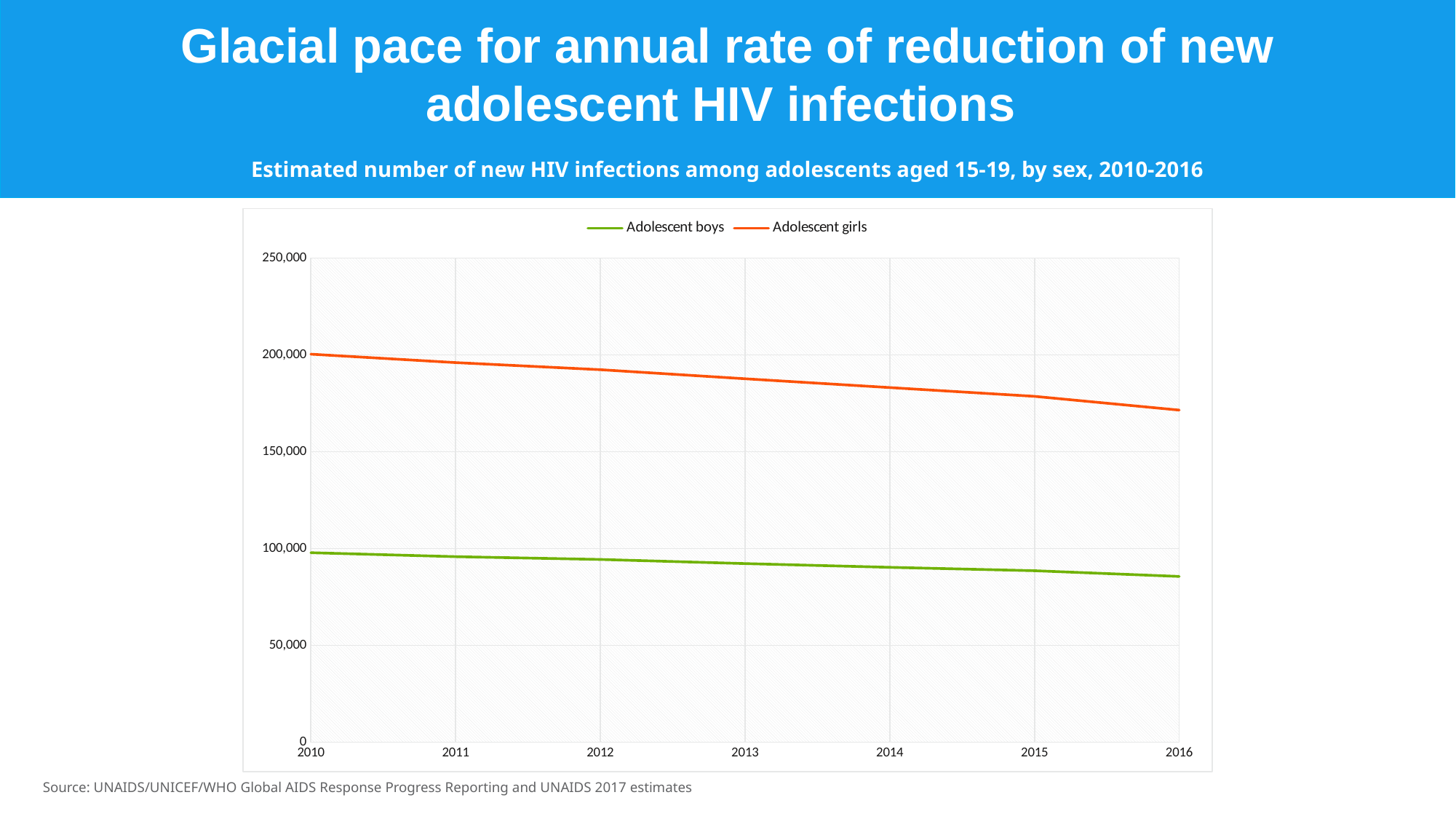
Which series has the higher value in 2016, Adolescent boys or Adolescent girls? Adolescent girls Is the value for Adolescent boys in 2016 greater or less than 50,000? greater Is the value for Adolescent girls in 2016 greater or less than 150,000? greater How many years are plotted along the x axis? 7 Is the value for Adolescent boys in 2010 greater or less than 100,000? less What kind of chart is shown on the slide? Line chart Which colour is used for the Adolescent boys line? Green Do the values for Adolescent boys rise or fall from 2010 to 2016? Fall How many series does the legend list? 2 What is the subtitle describing the chart's data? Estimated number of new HIV infections among adolescents aged 15-19, by sex, 2010-2016 Do the values for Adolescent girls rise or fall from 2010 to 2016? Fall